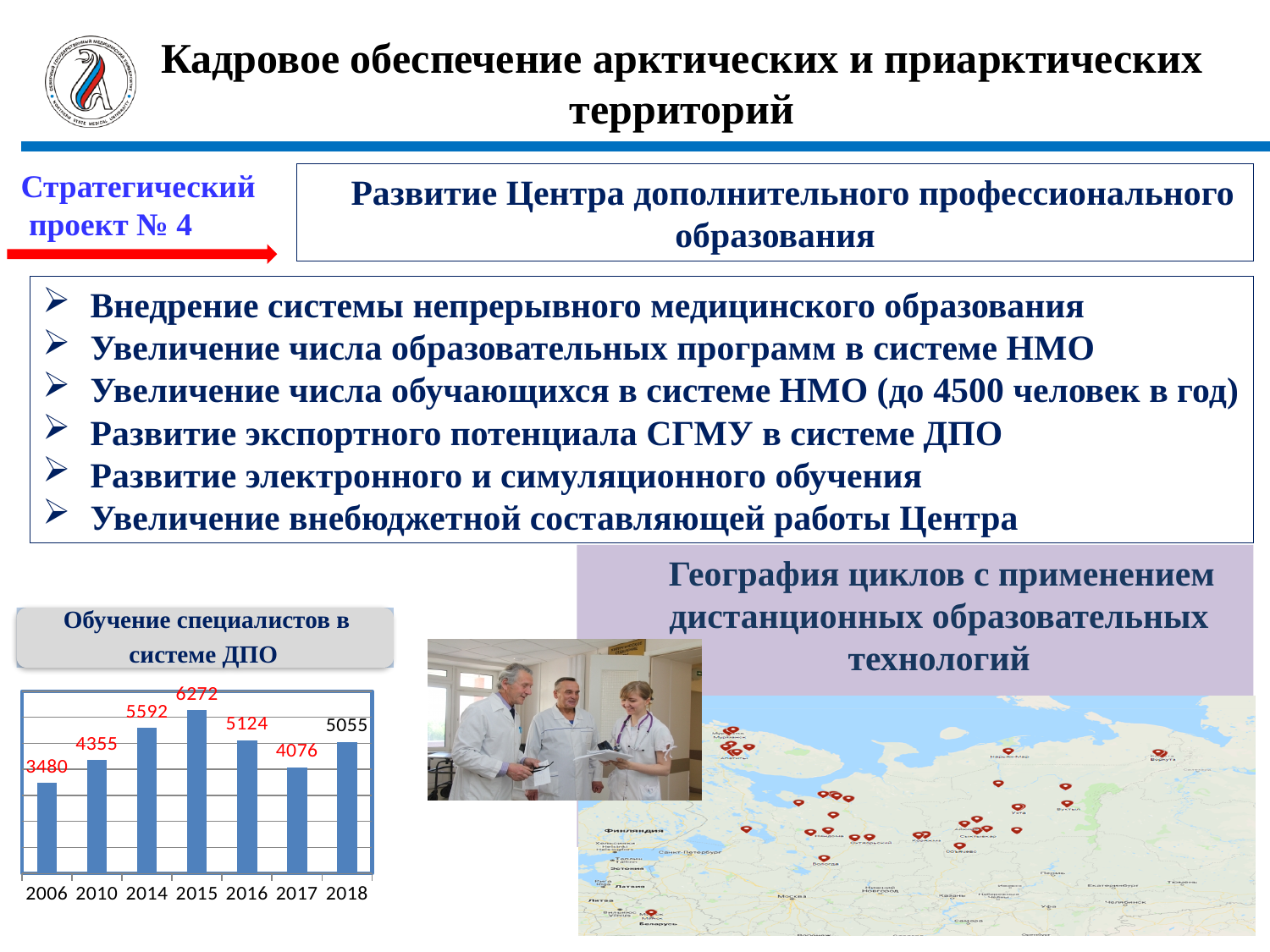
Which year has the highest value in the "Обучение специалистов в системе ДПО" chart? 2015 What is the value for 2017 in the "Обучение специалистов в системе ДПО" chart? 4076 How many years are shown on the x axis of the "Обучение специалистов в системе ДПО" chart? 7 What is the value for 2006 in the "Обучение специалистов в системе ДПО" chart? 3480 What is the difference between the values for 2015 and 2017 in the "Обучение специалистов в системе ДПО" chart? 2196 What is the value for 2018 in the "Обучение специалистов в системе ДПО" chart? 5055 What is the difference between the values for 2010 and 2006 in the "Обучение специалистов в системе ДПО" chart? 875 Which year has the lowest value in the "Обучение специалистов в системе ДПО" chart? 2006 In the "Обучение специалистов в системе ДПО" chart, do the values rise or fall from 2006 to 2015? rise What is the value for 2015 in the "Обучение специалистов в системе ДПО" chart? 6272 In the "Обучение специалистов в системе ДПО" chart, which is larger: the value for 2016 or the value for 2018? 2016 What type of chart is shown under the heading "Обучение специалистов в системе ДПО"? bar chart